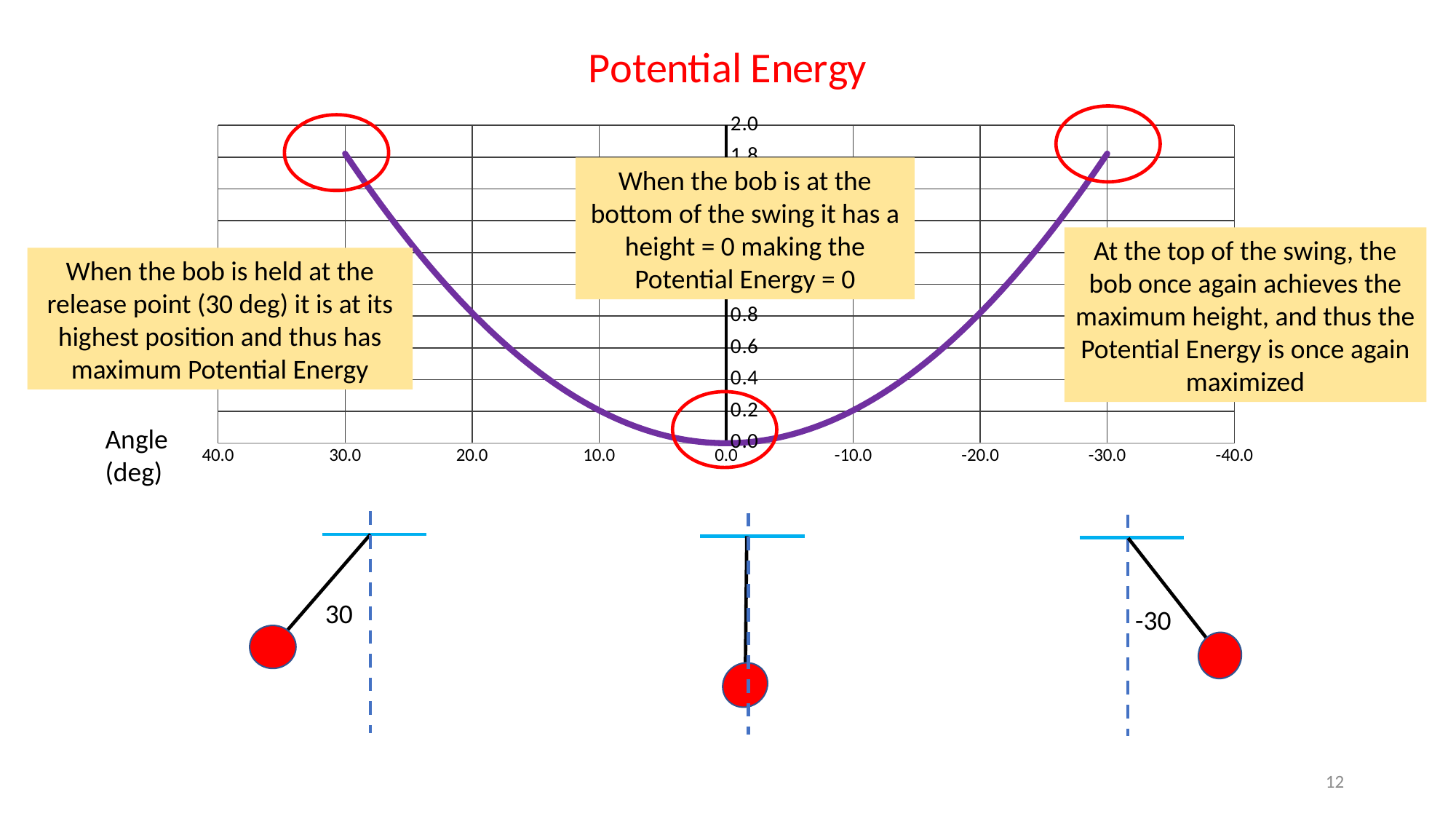
What is the Potential Energy value when the angle is 0.0 degrees? 0.0 Is the value of the curve at an angle of 10.0 greater or less than 0.4? less Is the value of the curve at an angle of -30.0 greater or less than 1.0? greater What kind of chart is shown on the slide? line chart How many tick labels are shown on the horizontal axis of the chart? 9 What is the label of the horizontal axis of the chart? Angle (deg) Is the value of the curve at an angle of 20.0 greater or less than 0.6? greater What is the title of the chart? Potential Energy Which has the larger Potential Energy value: an angle of 30.0 or an angle of 0.0? 30.0 Moving along the x axis from 30.0 to 0.0, does the curve rise or fall? fall At which angle on the x axis does the curve reach its lowest value? 0.0